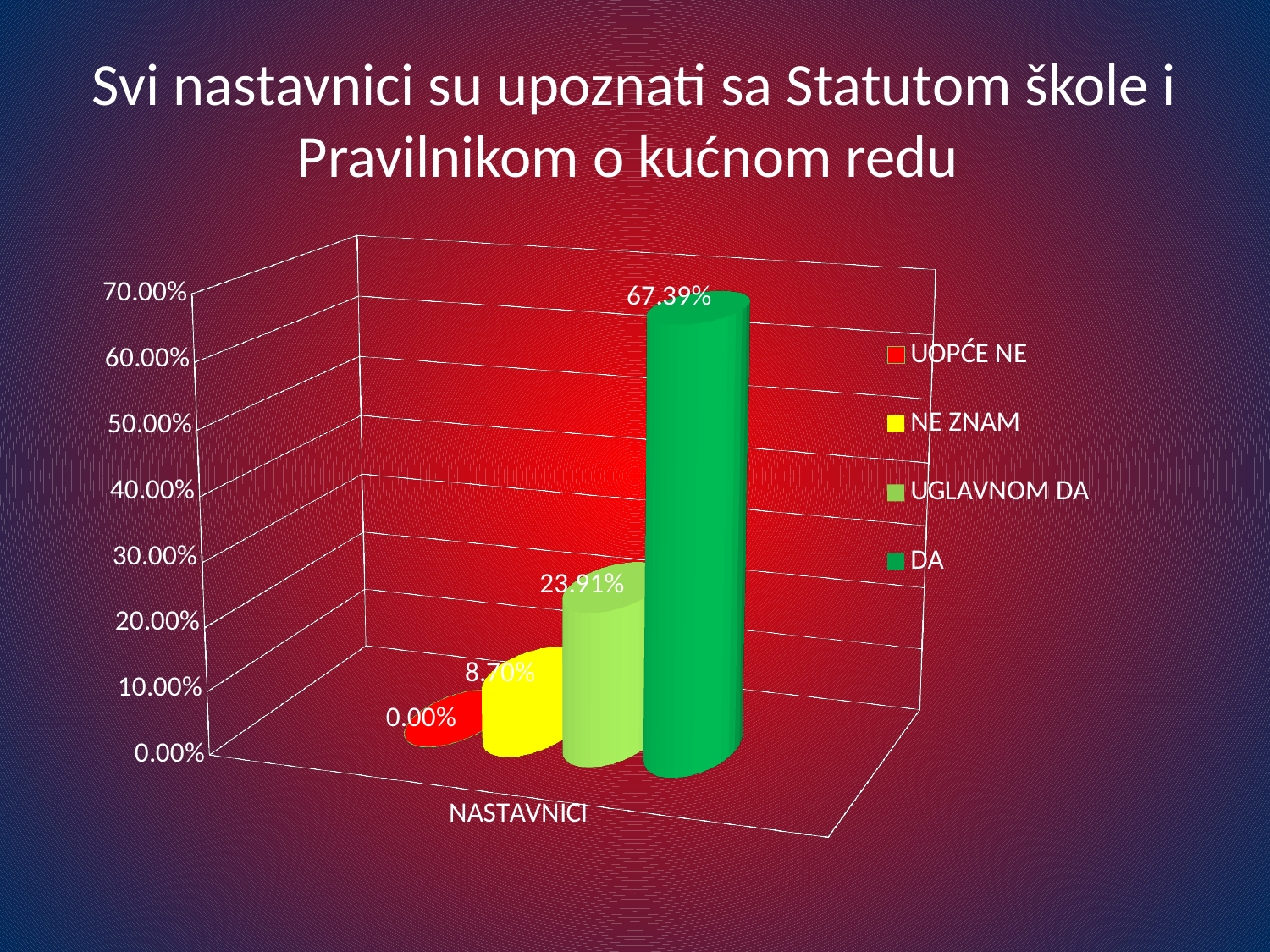
Which series has the highest value? DA Which is larger, the value for NE ZNAM or the value for UGLAVNOM DA? UGLAVNOM DA What is the value for UOPĆE NE? 0.00% What is the category label shown on the x axis? NASTAVNICI What is the value for DA? 67.39% Is the value for DA greater or less than 60.00%? greater What kind of chart is shown on the slide? bar chart What is the value for UGLAVNOM DA? 23.91% What is the value for NE ZNAM? 8.70% How many series does the legend list? 4 Which series has the lowest value? UOPĆE NE What is the difference between the values for DA and UGLAVNOM DA? 43.48%